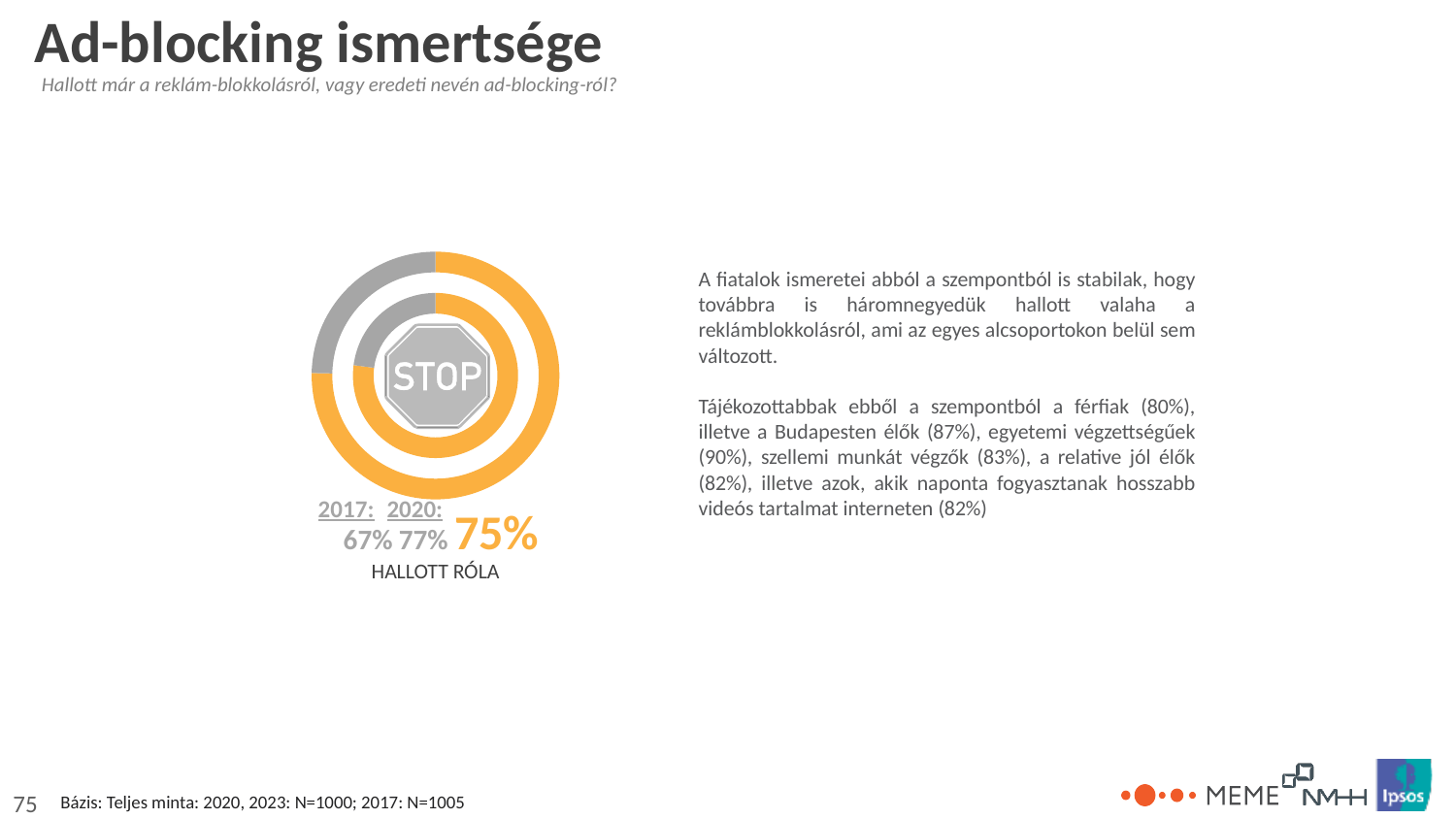
Did the value rise or fall from 2017 to 2020? Rise What is the difference between the 2020 value (77%) and the large highlighted value (75%)? 2 percentage points What label appears directly below the percentages under the donut chart? HALLOTT RÓLA What percentage is shown for 2020 in the donut chart? 77% What percentage is shown for 2017 in the donut chart? 67% By how many percentage points did the value increase from 2017 (67%) to 2020 (77%)? 10 percentage points What icon is shown in the centre of the donut chart? A STOP sign What kind of chart is shown on the slide? Donut (ring) chart What is the large orange percentage highlighted below the donut chart? 75% Which year has the higher value in the donut chart, 2017 or 2020? 2020 Is the 2017 value in the donut chart greater or less than 50%? greater How many concentric rings does the donut chart have? 3